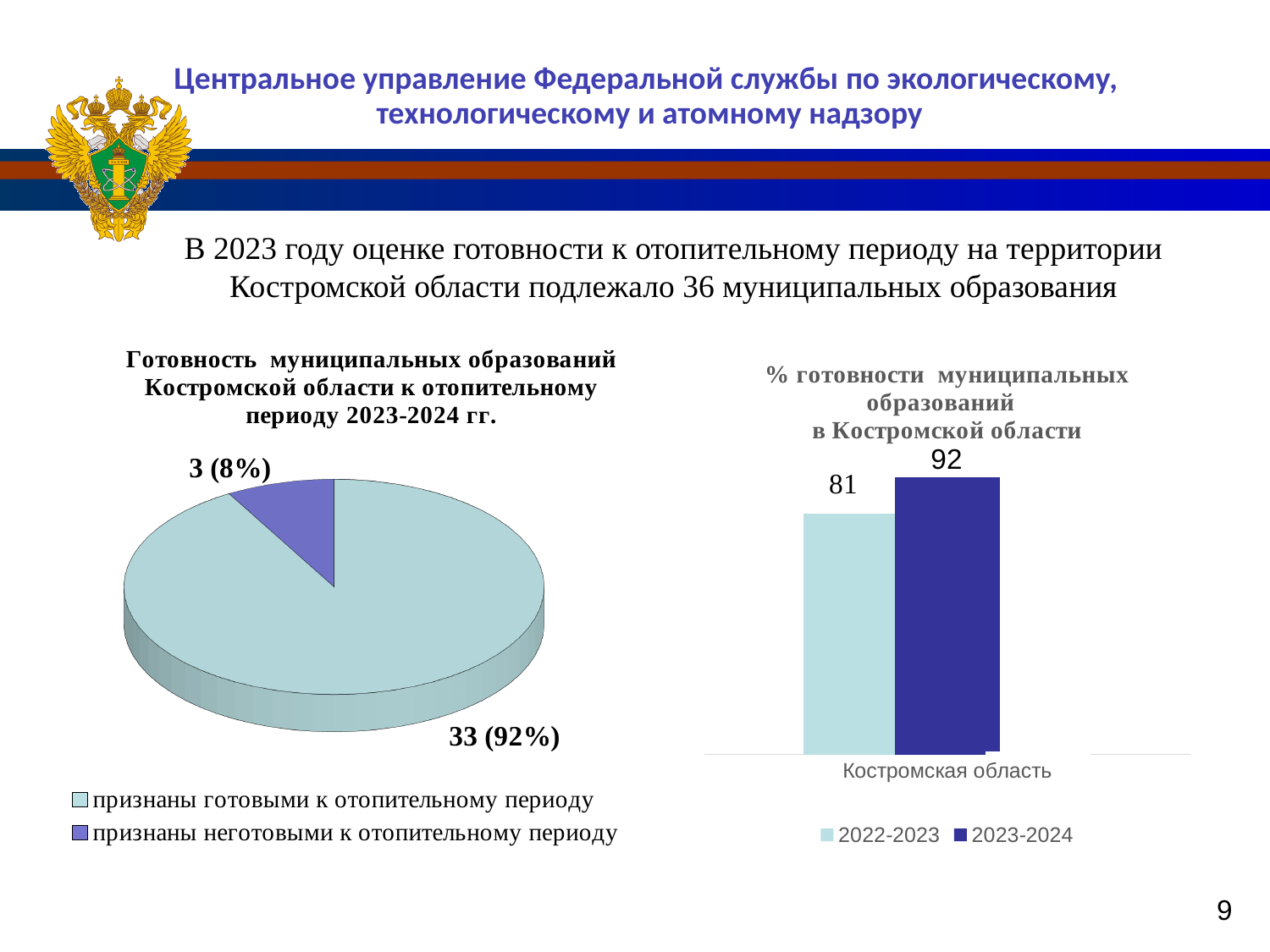
What type of chart is the chart on the left? pie chart In the pie chart on the left, what share of the pie is taken by municipalities recognised as not ready? 8% In the pie chart on the left, how many municipalities were recognised as not ready for the heating period (признаны неготовыми к отопительному периоду)? 3 (8%) What type of chart is the chart on the right? bar chart In the bar chart on the right, what is the value for 2023-2024 for Костромская область? 92 In the bar chart on the right, what is the difference between the 2023-2024 and 2022-2023 values? 11 In the bar chart on the right, how many series does the legend list? 2 In the pie chart on the left, which category is the largest? признаны готовыми к отопительному периоду In the bar chart on the right, what is the value for 2022-2023 for Костромская область? 81 In the pie chart on the left, how many municipalities were recognised as ready for the heating period (признаны готовыми к отопительному периоду)? 33 (92%) In the pie chart on the left, how many slices does the pie have? 2 In the bar chart on the right, which series has the larger value: 2022-2023 or 2023-2024? 2023-2024